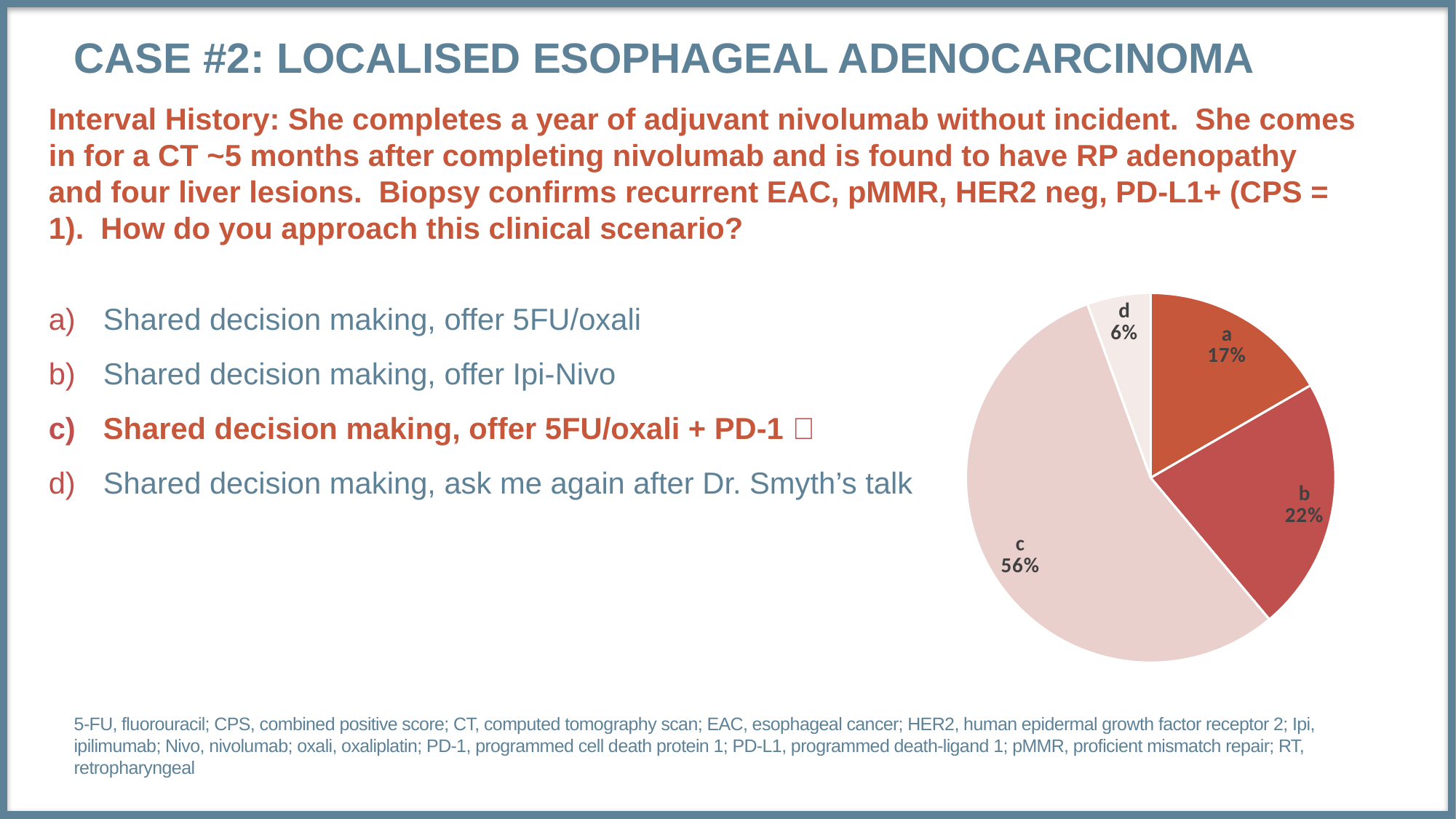
What type of chart is shown on the slide? Pie chart What percentage of the pie chart is labelled d? 6% What percentage of the pie chart is labelled b? 22% Which slice is larger in the pie chart, a or b? b Which slice of the pie chart is the lightest in colour? d How many slices does the pie chart have? 4 What percentage of the pie chart is labelled c? 56% What is the combined percentage of slices a and b in the pie chart? 39% Which slice of the pie chart is the smallest? d What is the difference in percentage points between slice c and slice b in the pie chart? 34 Which slice of the pie chart is the largest? c What percentage of the pie chart is labelled a? 17%